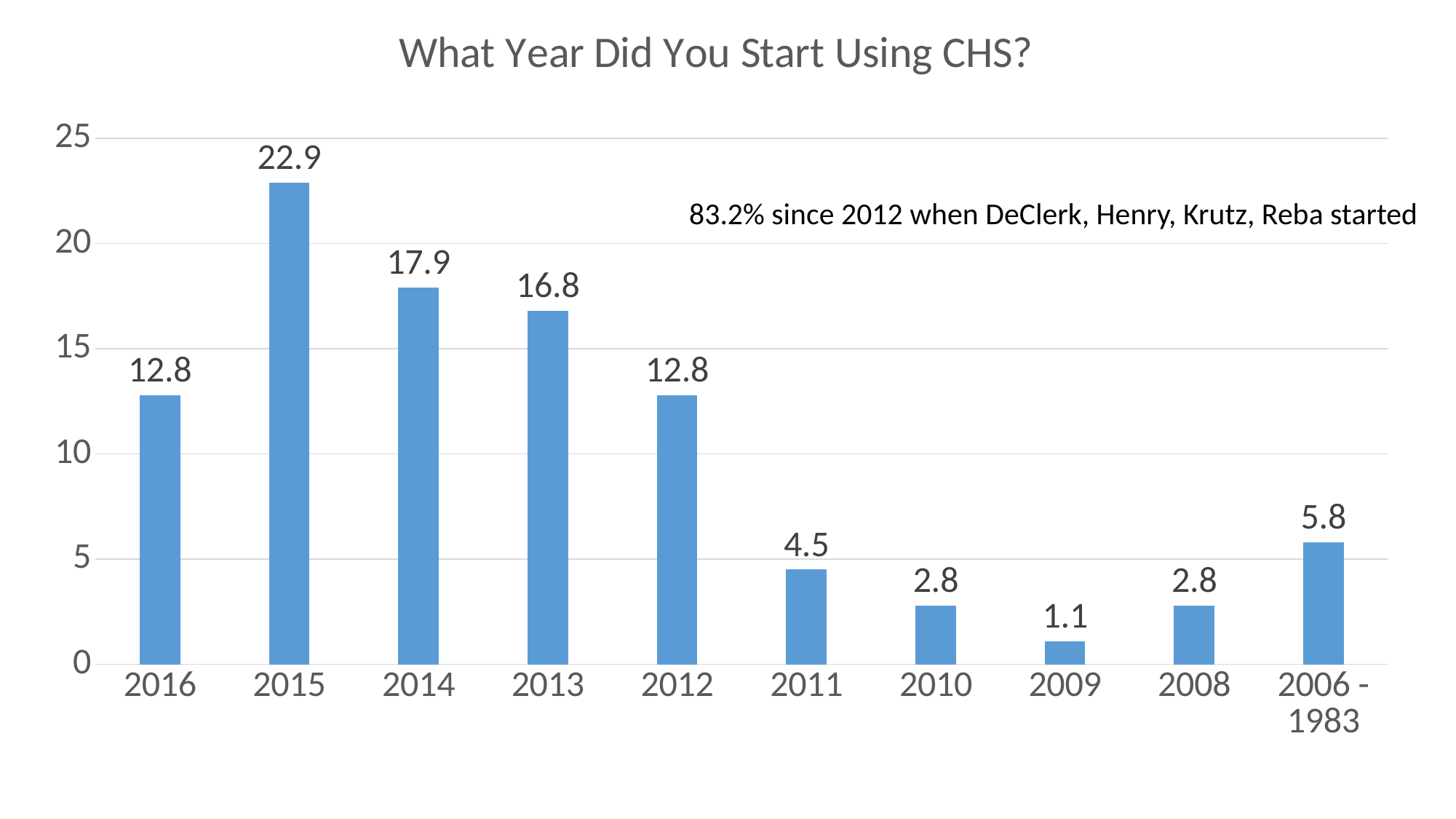
What is the value for 2015? 22.9 Which year has the highest value? 2015 Is the value for 2013 greater or less than 15? greater Which year has the lowest value? 2009 What is the value for 2013? 16.8 What is the difference between the values for 2015 and 2014? 5.0 What is the difference between the values for 2011 and 2009? 3.4 How many categories are shown on the x axis? 10 What is the title of the chart? What Year Did You Start Using CHS? What is the value for the 2006 - 1983 category? 5.8 What kind of chart is this? bar chart Which is larger, the value for 2014 or the value for 2012? 2014